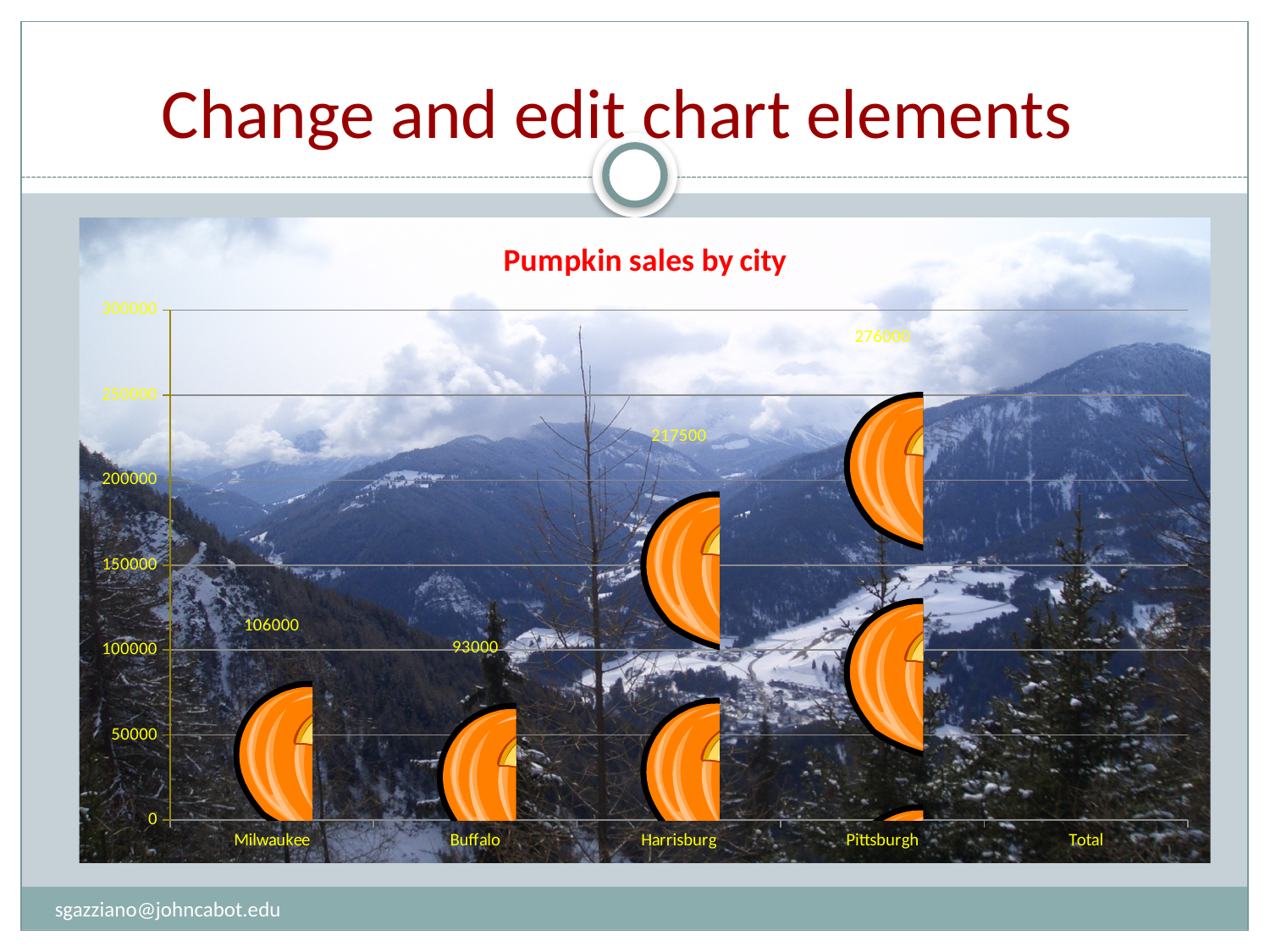
Which has higher pumpkin sales, Harrisburg or Milwaukee? Harrisburg What type of chart is shown on the slide? bar chart What is the pumpkin sales value for Buffalo? 93000 How many category labels are shown on the x axis? 5 What is the pumpkin sales value for Milwaukee? 106000 What is the title of the chart? Pumpkin sales by city What is the difference between the pumpkin sales of Pittsburgh and Harrisburg? 58500 What is the pumpkin sales value for Pittsburgh? 276000 Which city has the lowest labelled pumpkin sales value? Buffalo Is the value for Harrisburg greater or less than 200000? greater What is the pumpkin sales value for Harrisburg? 217500 Which city has the highest pumpkin sales? Pittsburgh